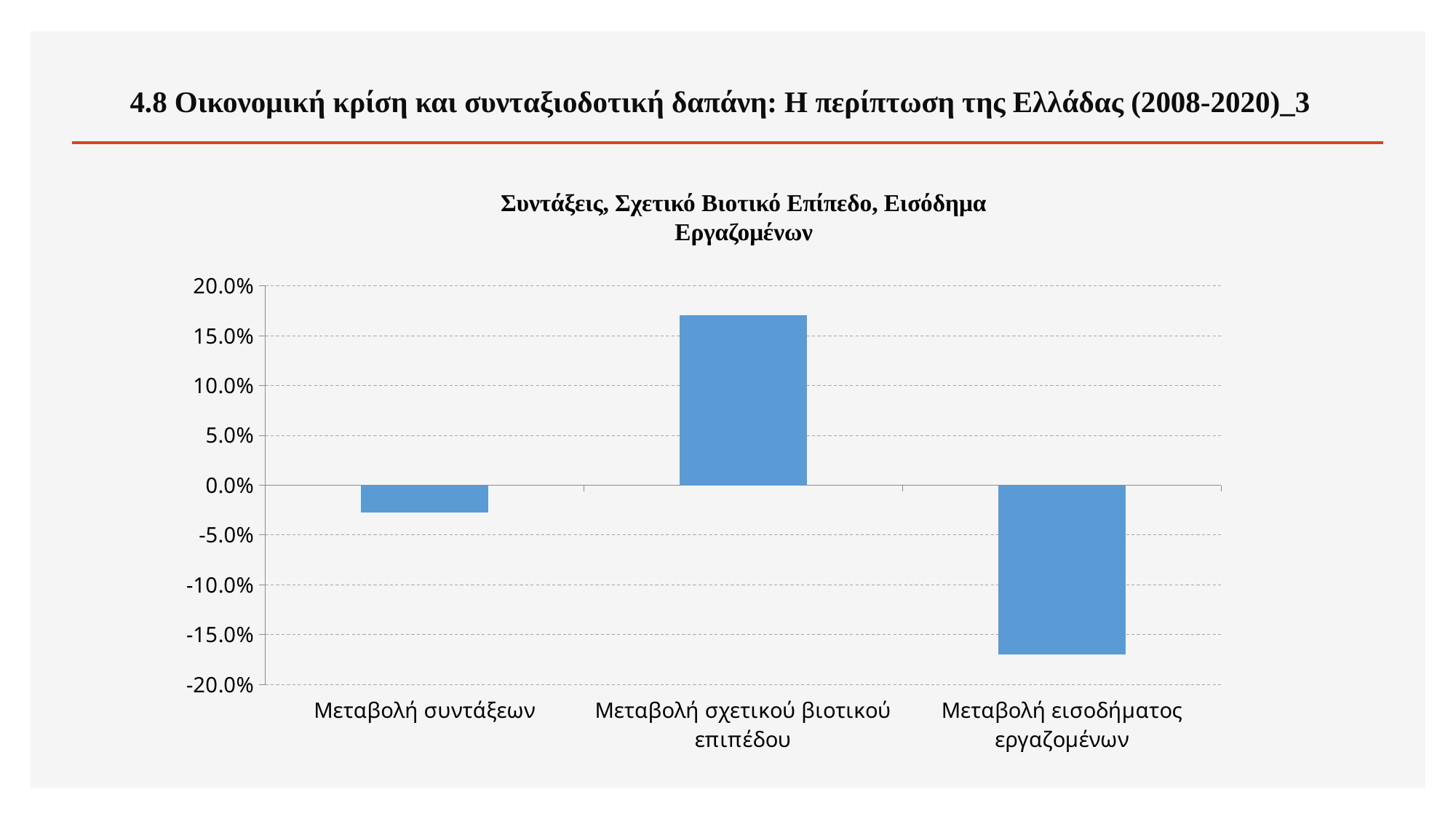
Is the value for Μεταβολή συντάξεων greater or less than -5.0%? greater How many categories are plotted in the chart? 3 Which category has the lowest value in the chart? Μεταβολή εισοδήματος εργαζομένων What is the title of the chart? Συντάξεις, Σχετικό Βιοτικό Επίπεδο, Εισόδημα Εργαζομένων Is the value for Μεταβολή σχετικού βιοτικού επιπέδου greater or less than 15.0%? greater What kind of chart is shown on the slide? Bar chart Is the value for Μεταβολή εισοδήματος εργαζομένων greater or less than -15.0%? less Which is larger, the value for Μεταβολή συντάξεων or the value for Μεταβολή εισοδήματος εργαζομένων? Μεταβολή συντάξεων Which category has the highest value in the chart? Μεταβολή σχετικού βιοτικού επιπέδου